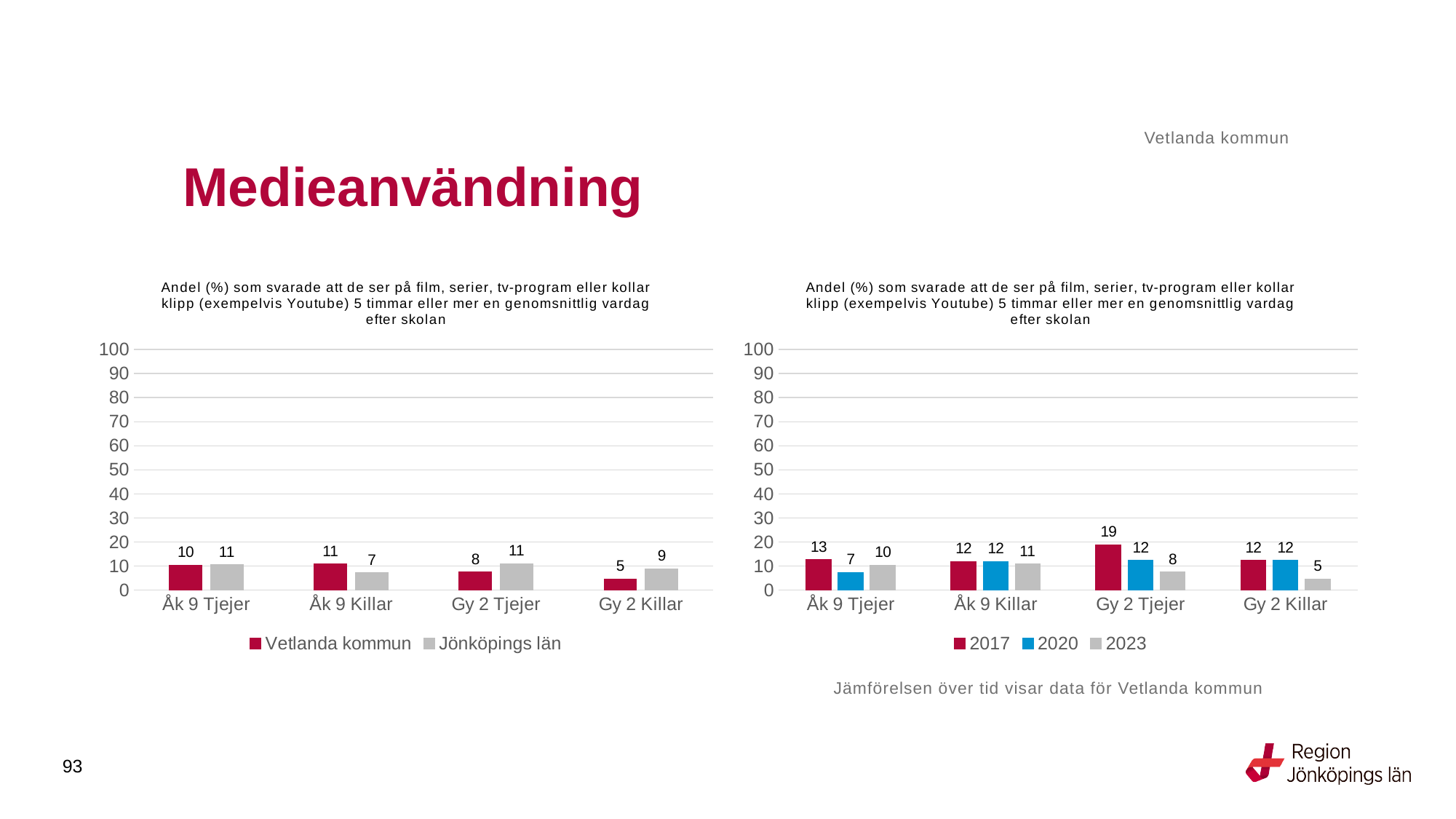
In the right chart, which category has the highest value for 2017? Gy 2 Tjejer What type of chart is the right chart? Bar chart In the left chart, what is the value for Vetlanda kommun for Åk 9 Tjejer? 10 In the left chart, what is the difference between Jönköpings län and Vetlanda kommun for Gy 2 Tjejer? 3 In the right chart, what is the value for 2017 for Gy 2 Tjejer? 19 In the right chart, what is the difference between 2017 and 2020 for Åk 9 Tjejer? 6 How many categories are shown on the x axis of the right chart? 4 In the left chart, which category has the lowest value for Vetlanda kommun? Gy 2 Killar In the left chart, which is larger for Åk 9 Killar: Vetlanda kommun or Jönköpings län? Vetlanda kommun In the left chart, what is the value for Jönköpings län for Gy 2 Killar? 9 How many series does the legend of the left chart list? 2 In the right chart, what is the value for 2023 for Gy 2 Killar? 5